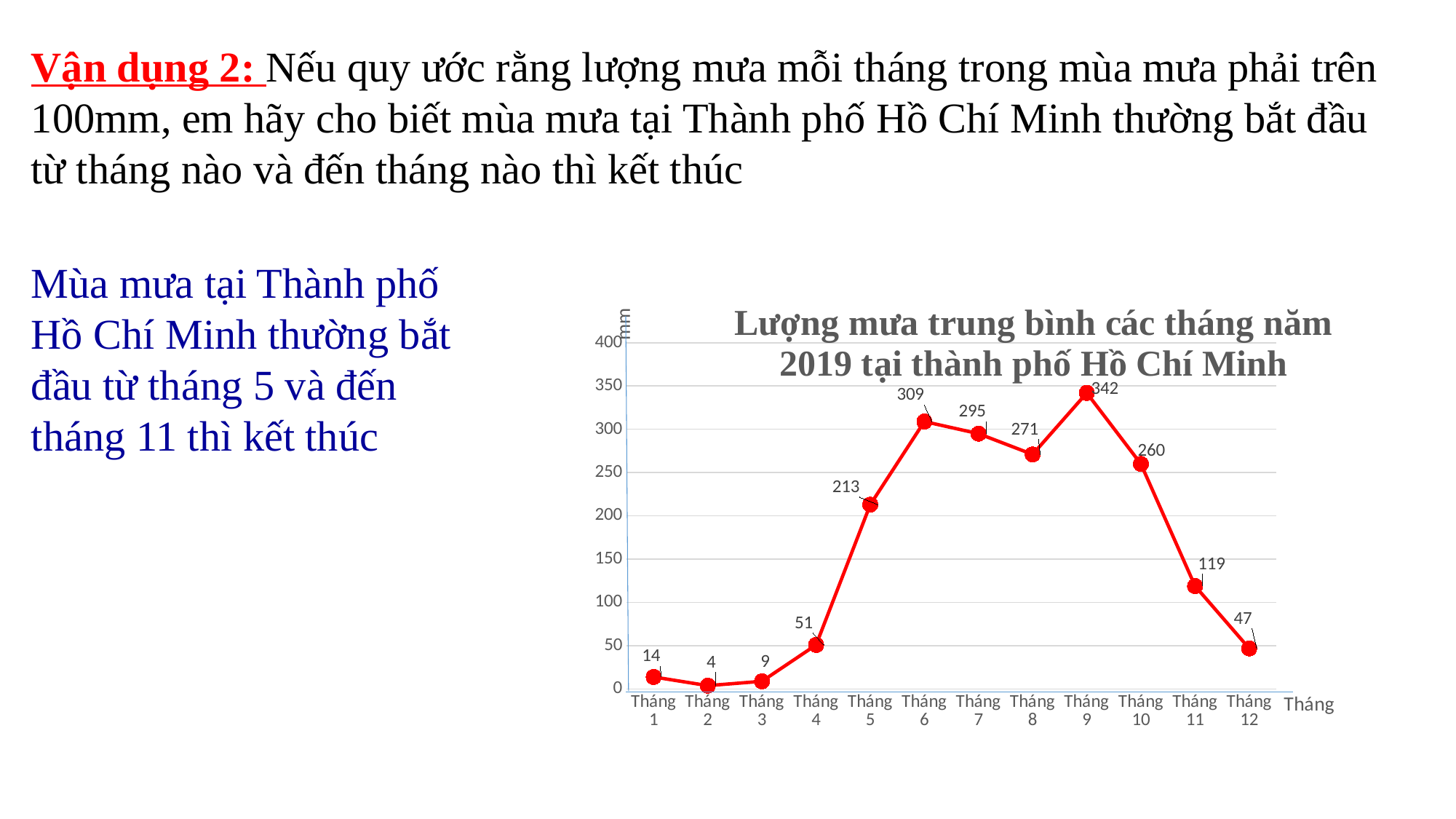
Which month has the lowest rainfall? Tháng 2 What unit is shown on the vertical axis? mm What is the title of the chart? Lượng mưa trung bình các tháng năm 2019 tại thành phố Hồ Chí Minh How many months are plotted on the chart? 12 What is the difference between the rainfall in Tháng 9 and Tháng 6? 33 Is the value for Tháng 4 greater or less than 100? less Which has higher rainfall, Tháng 7 or Tháng 8? Tháng 7 Do the values rise or fall from Tháng 9 to Tháng 12? fall What is the rainfall value for Tháng 5? 213 What is the rainfall value for Tháng 11? 119 What kind of chart is shown? line chart Which month has the highest rainfall? Tháng 9